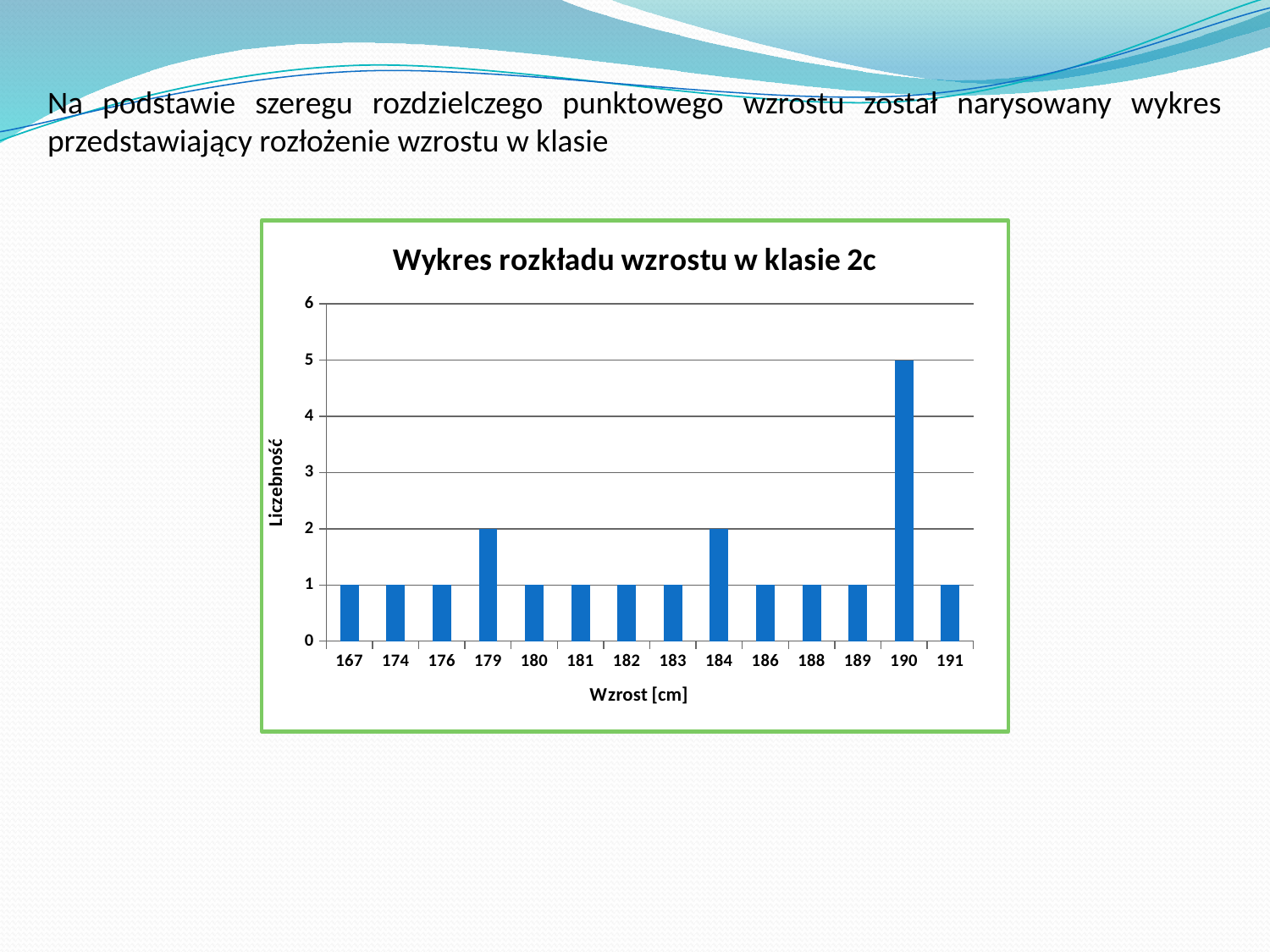
What is the value for 184 cm? 2 What kind of chart is shown on the slide? bar chart Is the value for 190 cm greater or less than 4? greater What is the value for 190 cm? 5 What is the value for 167 cm? 1 Which is larger, the value for 184 cm or the value for 186 cm? 184 What is the title of the chart? Wykres rozkładu wzrostu w klasie 2c What is the difference between the values for 190 cm and 179 cm? 3 What is the label of the x axis? Wzrost [cm] How many height categories are shown on the x axis? 14 Which height category has the highest count? 190 What is the value for 179 cm? 2